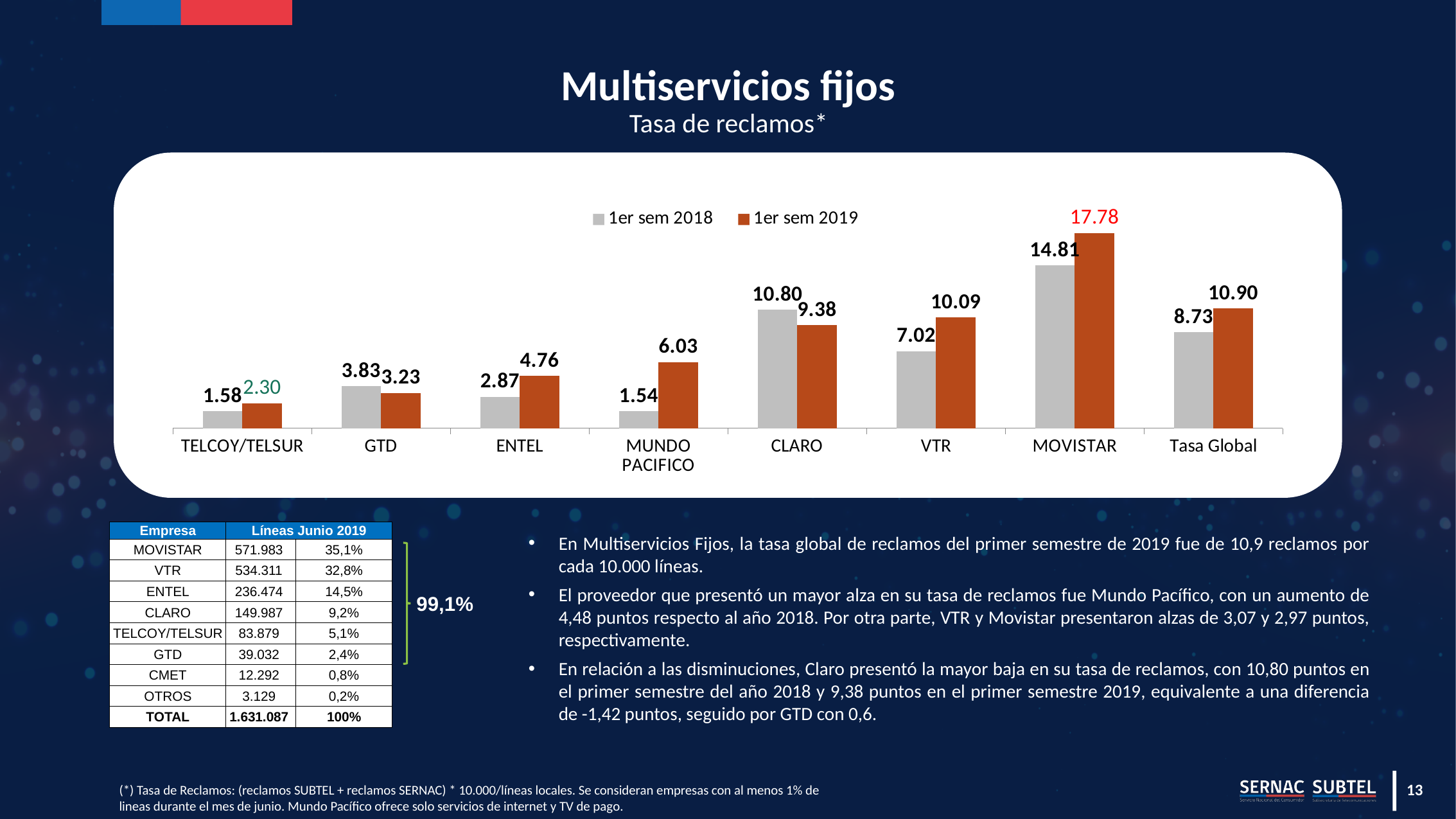
What is the value for MOVISTAR in the 1er sem 2019 series? 17.78 What is the value for MUNDO PACIFICO in the 1er sem 2018 series? 1.54 What is the difference between the 1er sem 2019 and 1er sem 2018 values for VTR? 3.07 What kind of chart is shown on the slide? Bar chart Which is larger for CLARO: the 1er sem 2018 value or the 1er sem 2019 value? 1er sem 2018 How many series does the chart legend list? 2 Which series is shown in orange in the chart? 1er sem 2019 Which category has the lowest value in the 1er sem 2018 series? MUNDO PACIFICO What is the difference between the 1er sem 2019 and 1er sem 2018 values for MUNDO PACIFICO? 4.49 How many categories are shown on the x axis of the chart? 8 What is the Tasa Global value for 1er sem 2019? 10.90 Which category has the highest value in the 1er sem 2019 series? MOVISTAR